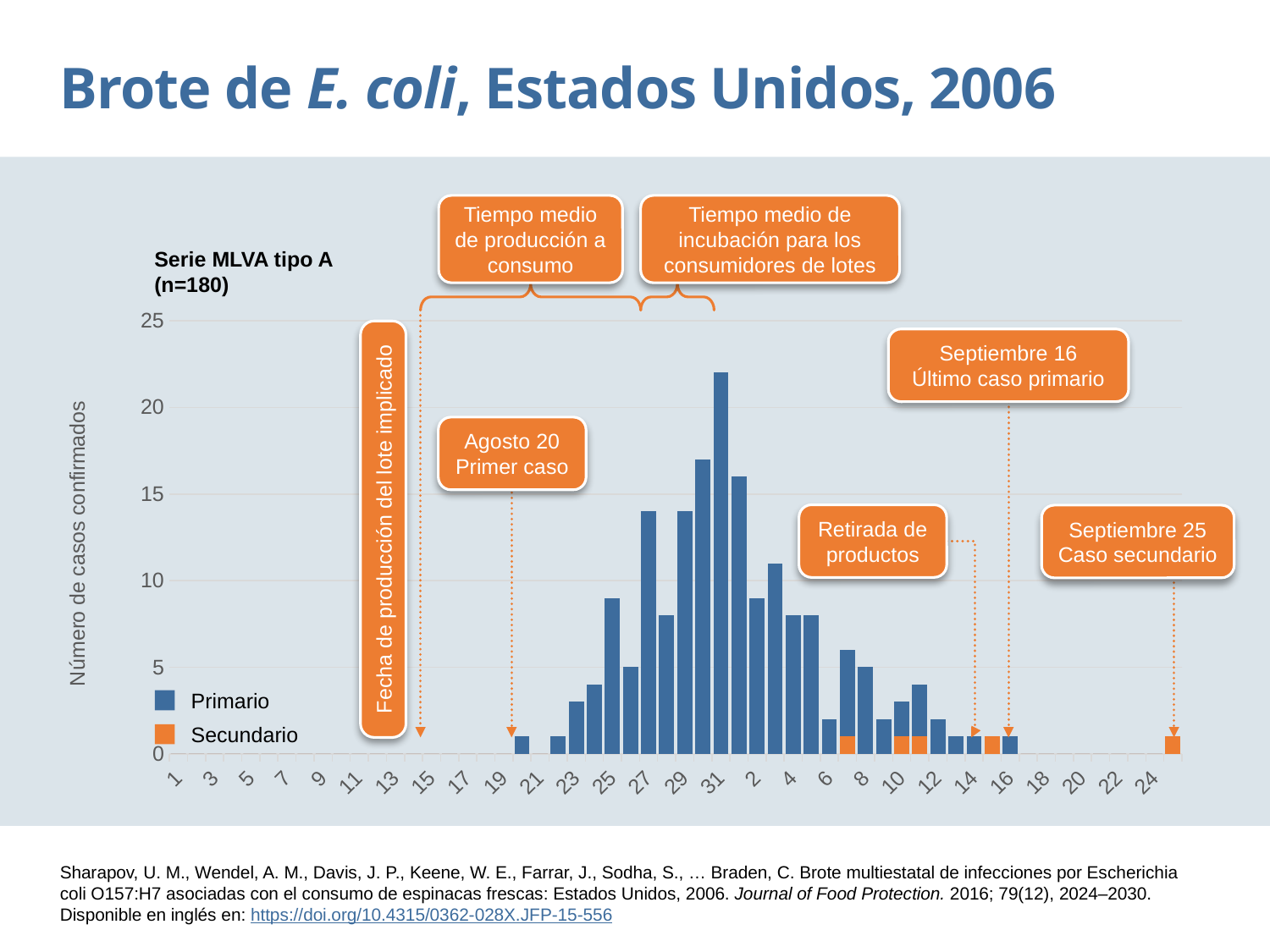
Is the value for day 30 greater or less than 15? greater What is the total number of cases (n) stated for the MLVA type A series? 180 Which bar is taller, the one for day 31 or the one for day 2? Day 31 What are the two series named in the legend? Primario and Secundario What kind of chart is shown on the slide? Bar chart According to the annotation, on what date was the first case (Primer caso)? Agosto 20 According to the annotation, on what date was the last primary case (Último caso primario)? Septiembre 16 How many series does the legend list? 2 Is the value of the tallest bar (day 31) greater or less than 20? greater What is the label of the vertical axis? Número de casos confirmados On which day does the tallest bar occur? 31